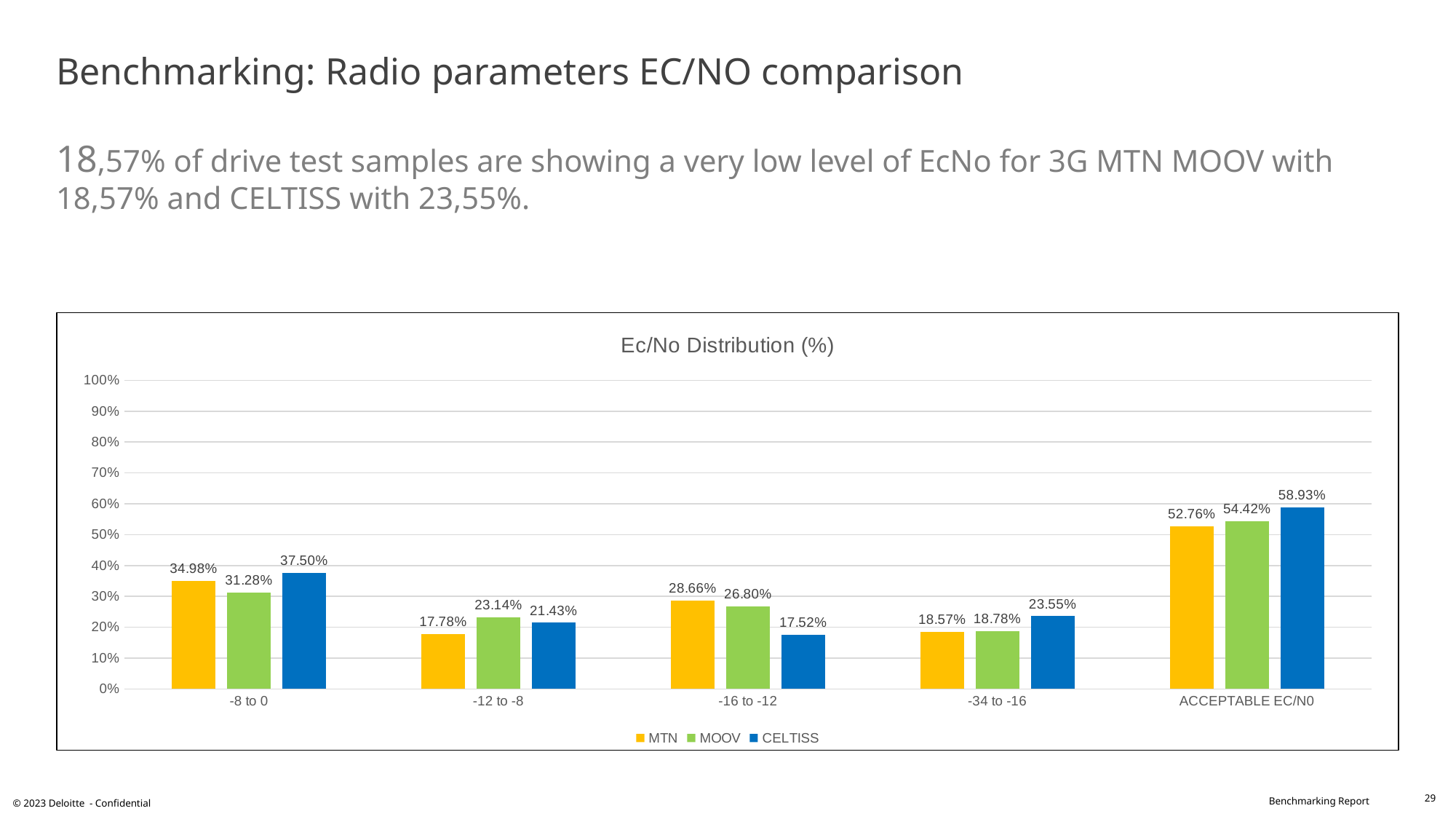
Which series has the highest value in the -8 to 0 category? CELTISS What is the value for MTN in the -16 to -12 category? 28.66% What is the value for MOOV in the -12 to -8 category? 23.14% What is the title of the chart? Ec/No Distribution (%) What kind of chart is shown on the slide? Bar chart How many series does the legend list? 3 Which is larger in the -12 to -8 category, the MTN value or the CELTISS value? CELTISS Is the value for MOOV in the ACCEPTABLE EC/N0 category greater or less than 50%? greater What is the value for CELTISS in the ACCEPTABLE EC/N0 category? 58.93% What is the difference between the CELTISS and MTN values in the ACCEPTABLE EC/N0 category? 6.17% Which series has the lowest value in the -16 to -12 category? CELTISS How many categories are shown on the x axis? 5